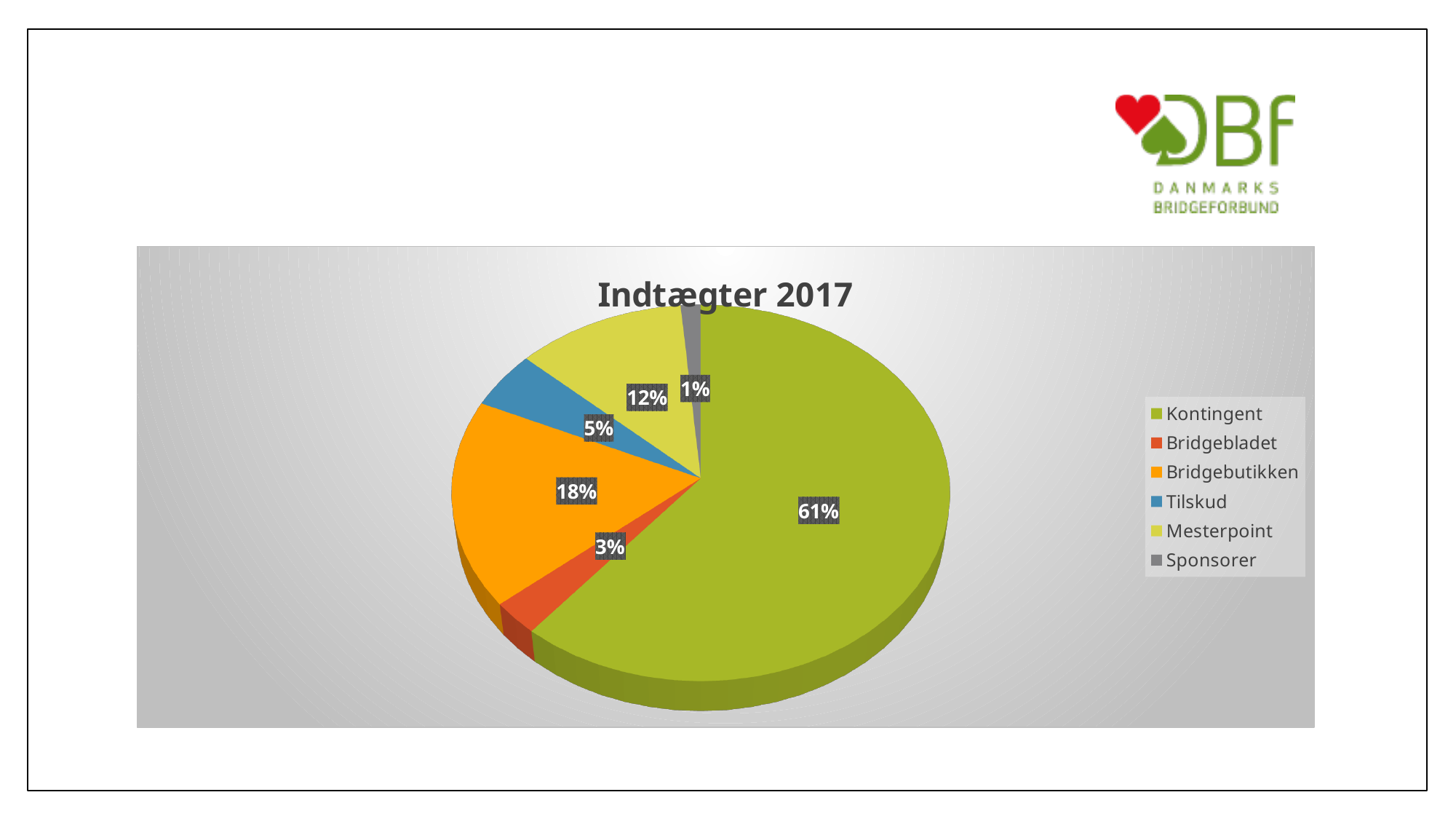
What is the value shown for Bridgebladet? 3% What share of the pie does Kontingent represent? 61% Which category has the largest slice of the pie? Kontingent What is the value shown for Bridgebutikken? 18% What is the difference in percentage points between Bridgebutikken and Mesterpoint? 6 What is the title of the chart? Indtægter 2017 Which is larger, Tilskud or Bridgebladet? Tilskud What is the value shown for Mesterpoint? 12% What is the value shown for Tilskud? 5% Which category has the smallest slice of the pie? Sponsorer What kind of chart is shown on the slide? Pie chart How many categories does the pie chart show? 6